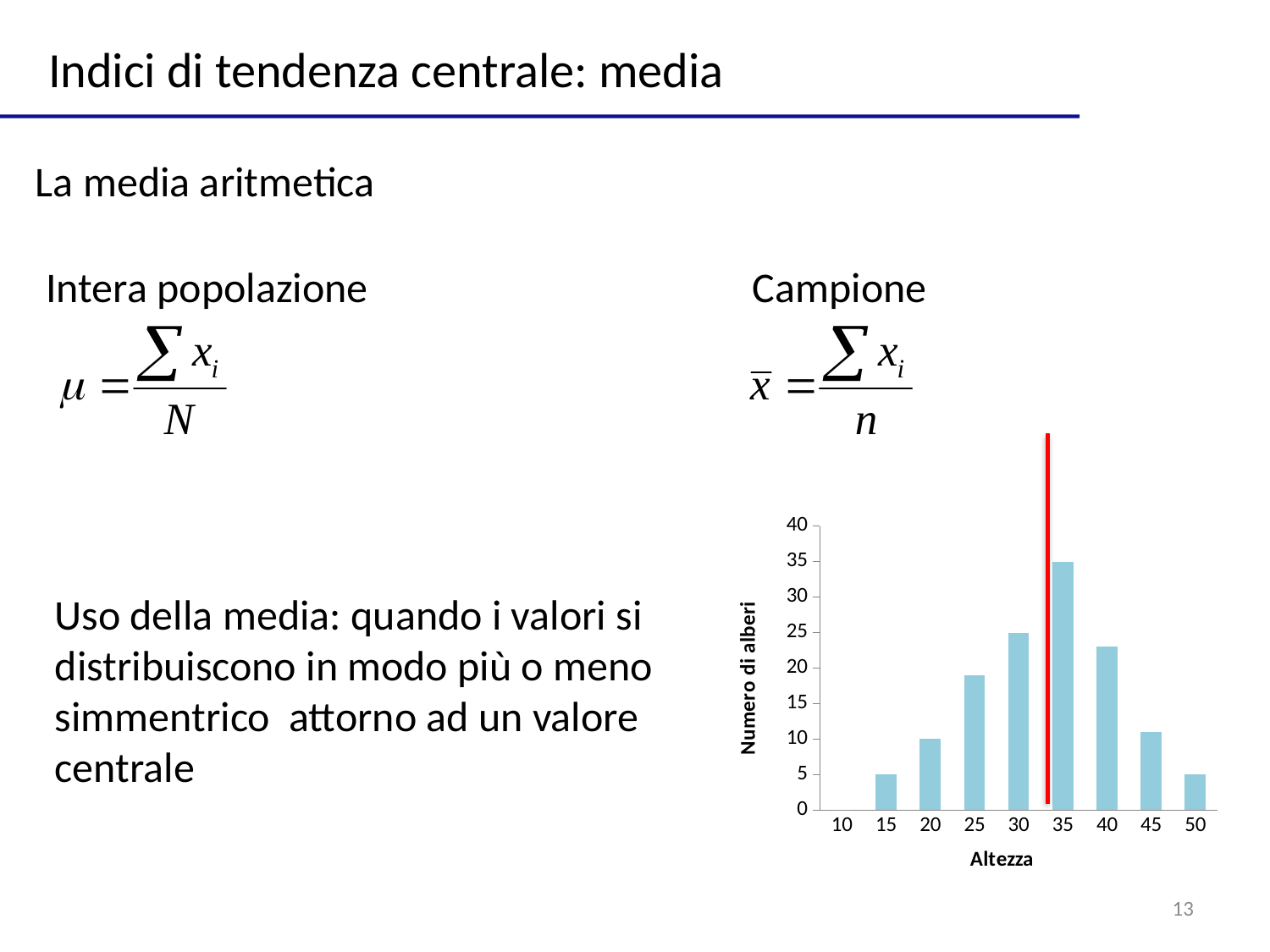
Is the value for Altezza 45 greater or less than 15? less Which is larger, the value for Altezza 25 or Altezza 45? Altezza 25 What is the value for Altezza 35? 35 What is the value for Altezza 15? 5 What is the value for Altezza 30? 25 Which Altezza category has the highest number of trees? 35 What kind of chart is shown on the slide? bar chart What is the title of the y axis of the chart? Numero di alberi What is the value for Altezza 20? 10 What is the title of the x axis of the chart? Altezza How many category labels are shown on the x axis? 9 Is the value for Altezza 25 greater or less than 15? greater